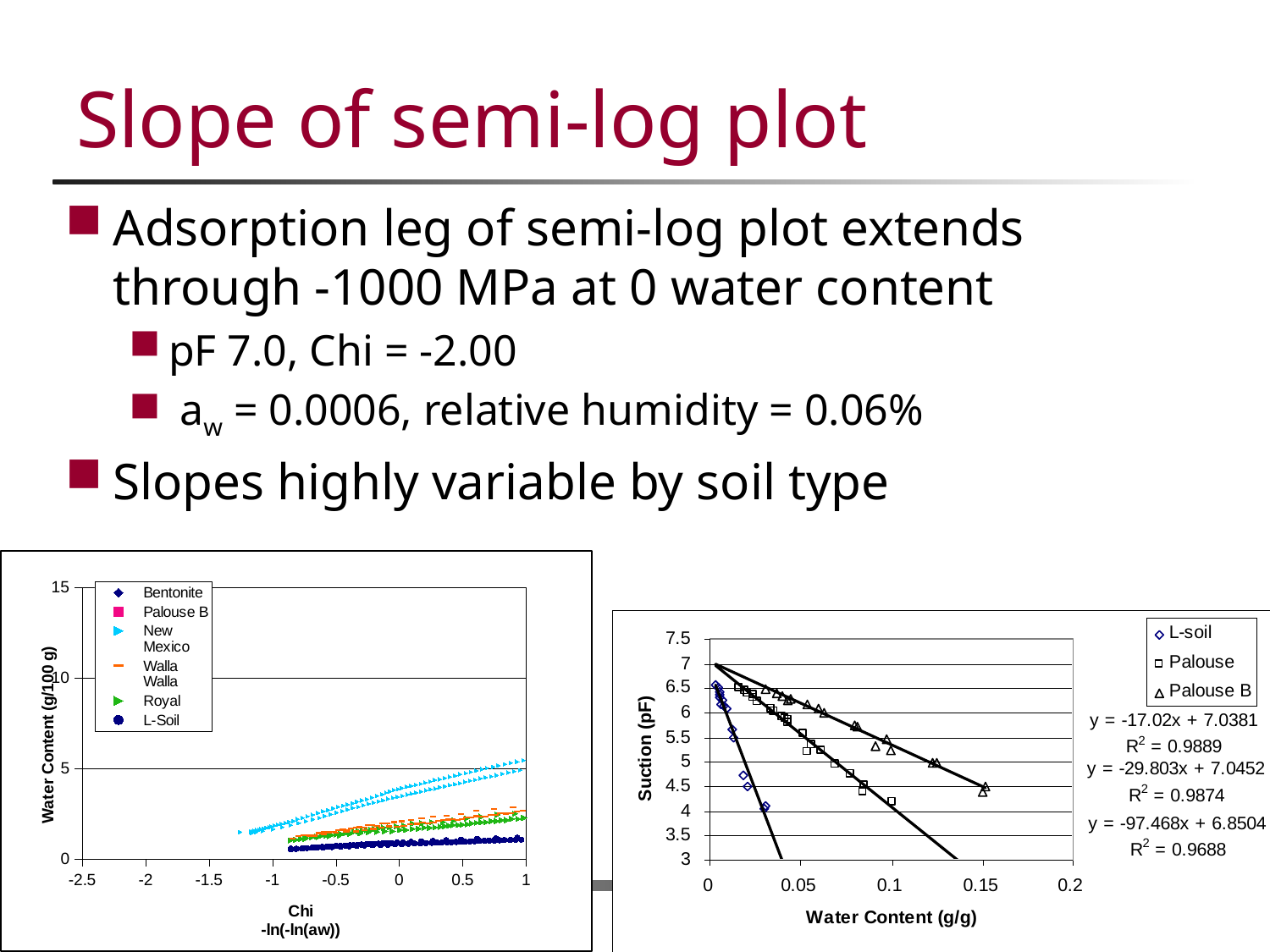
What kind of chart is the right chart (Suction vs Water Content)? scatter plot What is the y-axis title of the left chart? Water Content (g/100 g) On the right chart, how many series does the legend list? 3 On the right chart, what is the slope of the trendline with intercept 7.0452? -29.803 On the right chart, what is the R² value shown for the trendline y = -17.02x + 7.0381? 0.9889 On the right chart, does suction rise or fall as water content increases along the x axis? fall On the left chart, which series has the highest water content at Chi = 1? New Mexico On the right chart, what is the R² value shown for the trendline y = -97.468x + 6.8504? 0.9688 On the left chart, which series has the lowest water content at Chi = 1? L-Soil On the right chart, is the suction for Palouse B at a water content of 0.15 greater or less than 5? less On the left chart, is the water content for New Mexico at Chi = 1 greater or less than 2.5? greater On the left chart, how many series does the legend list? 6